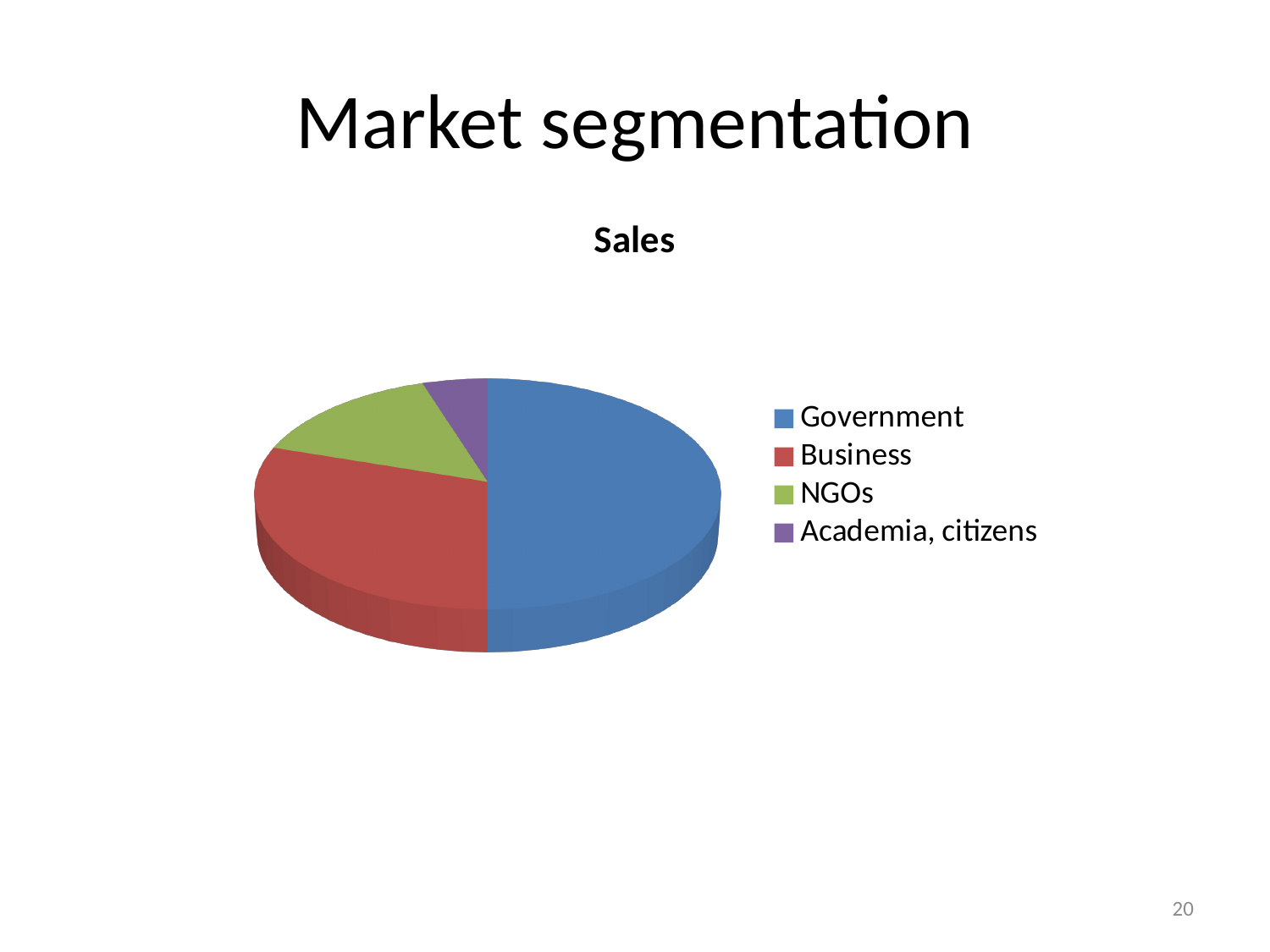
Which category has the smallest slice of the pie? Academia, citizens Which slice is larger, Business or NGOs? Business Which colour represents the Business slice? red Which category has the largest slice of the pie? Government What is the title of the chart? Sales Which slice is larger, Government or Business? Government Which slice is larger, NGOs or Academia, citizens? NGOs How many slices does the pie chart have? 4 What kind of chart is shown on the slide? pie chart How many entries does the legend list? 4